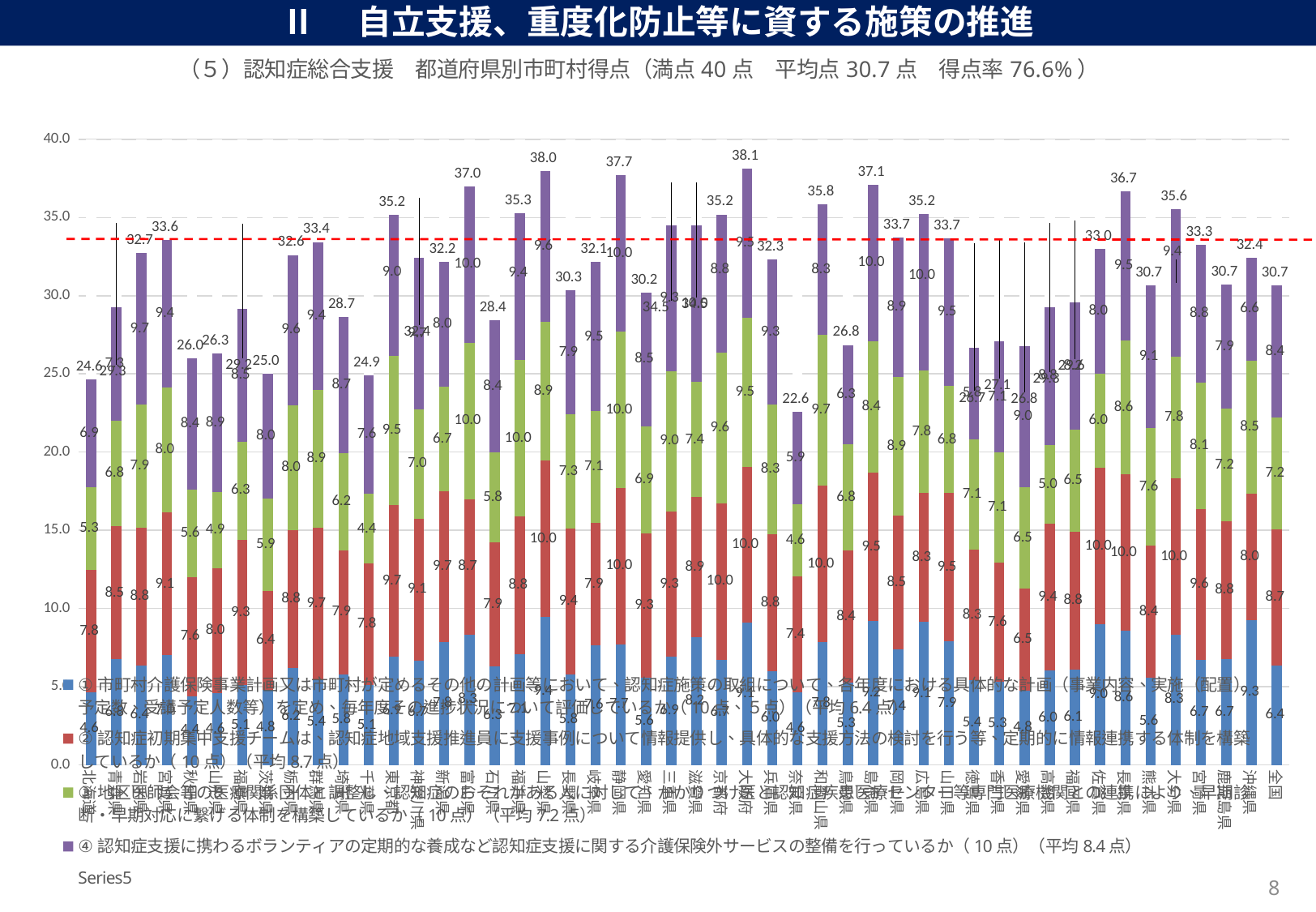
What is the value of the red segment of the 全国 bar? 8.7 In the 全国 bar, which is larger: the red segment or the green segment? red segment What is the highest total score labeled on any bar in the chart? 38.1 What kind of chart is shown on the slide? bar chart How many series does the legend list? 5 According to the chart title, what is the maximum possible score (満点)? 40 点 What is the value of the top (purple) segment of the 全国 bar? 8.4 What is the lowest total score labeled on any bar in the chart? 22.6 What is the value of the green segment of the 全国 bar? 7.2 What is the difference between the purple and green segments of the 全国 bar? 1.2 What is the total score shown for 全国 (the rightmost bar)? 30.7 What is the value of the bottom (blue) segment of the 全国 bar? 6.4